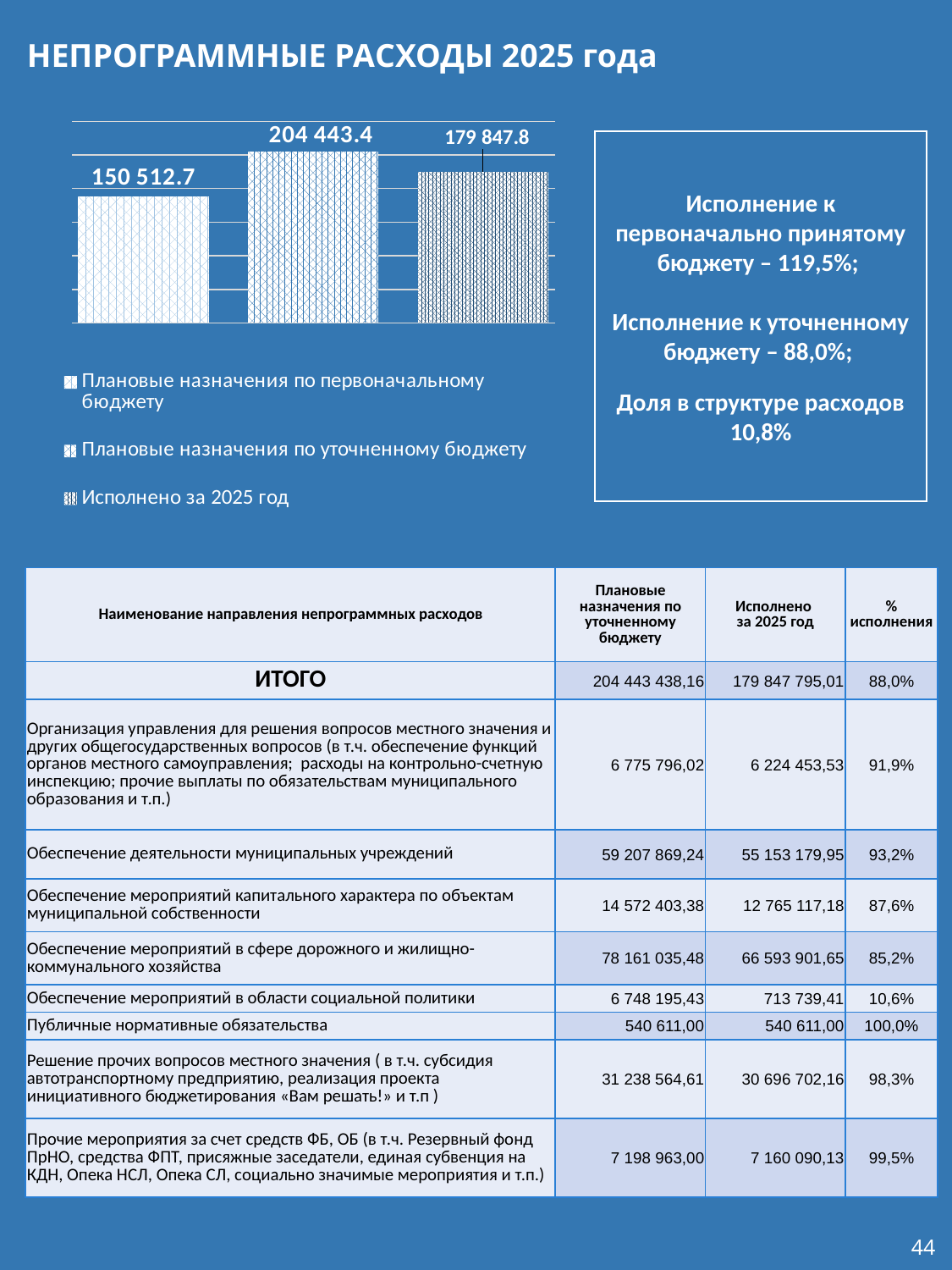
What is the difference between "Плановые назначения по уточненному бюджету" and "Исполнено за 2025 год"? 24 595.6 What is the difference between "Исполнено за 2025 год" and "Плановые назначения по первоначальному бюджету"? 29 335.1 Which series has the highest value in the chart? Плановые назначения по уточненному бюджету What is the value for "Исполнено за 2025 год"? 179 847.8 What is the value for "Плановые назначения по уточненному бюджету"? 204 443.4 Which is larger: "Исполнено за 2025 год" or "Плановые назначения по первоначальному бюджету"? Исполнено за 2025 год How many series does the legend list? 3 Which series has the lowest value in the chart? Плановые назначения по первоначальному бюджету What is the title of the slide containing the chart? НЕПРОГРАММНЫЕ РАСХОДЫ 2025 года What type of chart is shown on the slide? bar chart What is the value for "Плановые назначения по первоначальному бюджету"? 150 512.7 How many bars are plotted in the chart? 3